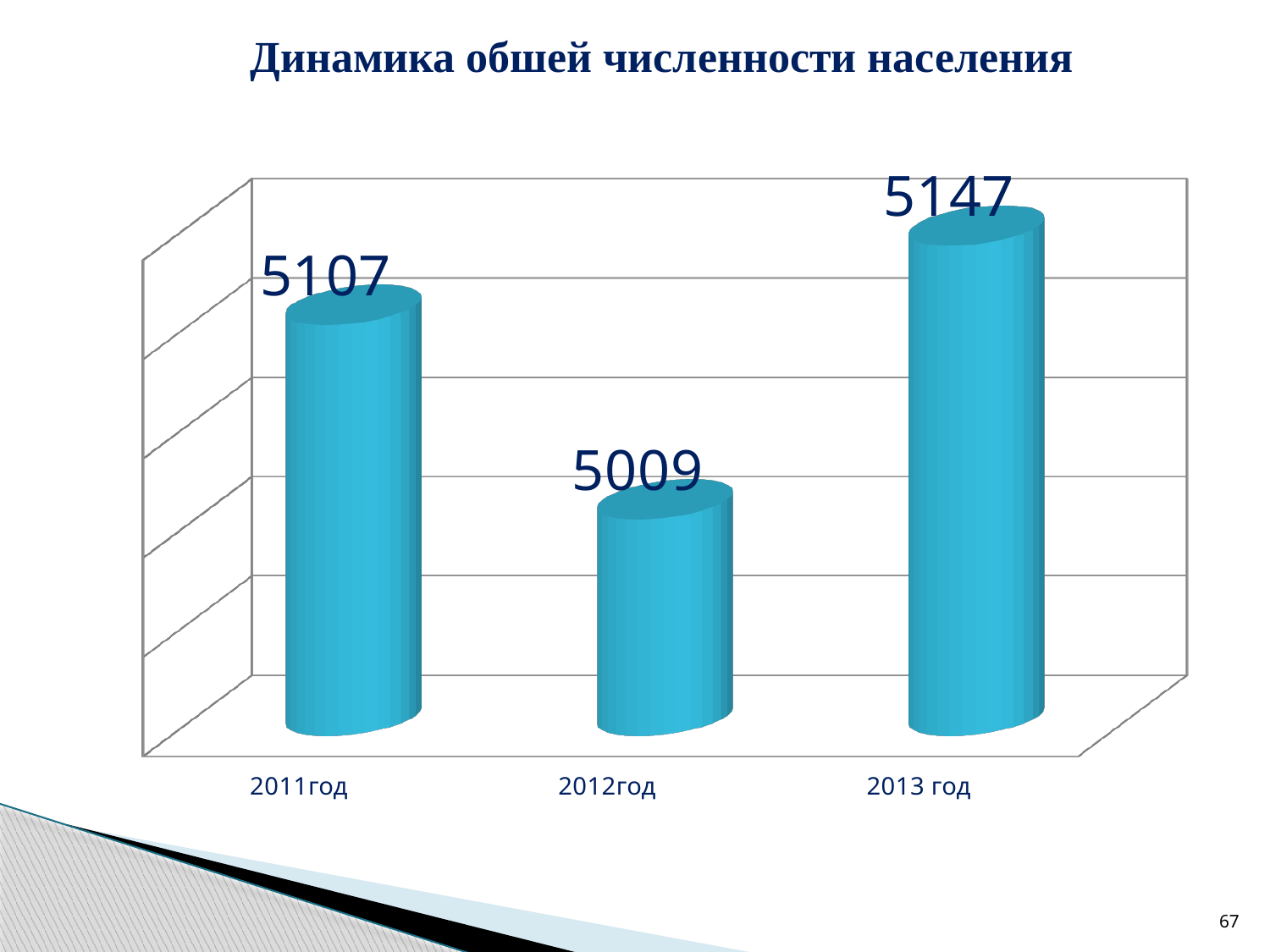
How many categories are shown on the x axis? 3 What is the difference between the values for 2011год and 2012год? 98 What is the value for 2011год? 5107 What is the value for 2012год? 5009 What is the difference between the values for 2013 год and 2012год? 138 What kind of chart is shown on the slide? bar chart Which is larger, the value for 2011год or the value for 2013 год? 2013 год Which year has the lowest value? 2012год Does the value rise or fall from 2012год to 2013 год? rise Which year has the highest value? 2013 год What is the title of the slide? Динамика обшей численности населения What is the value for 2013 год? 5147